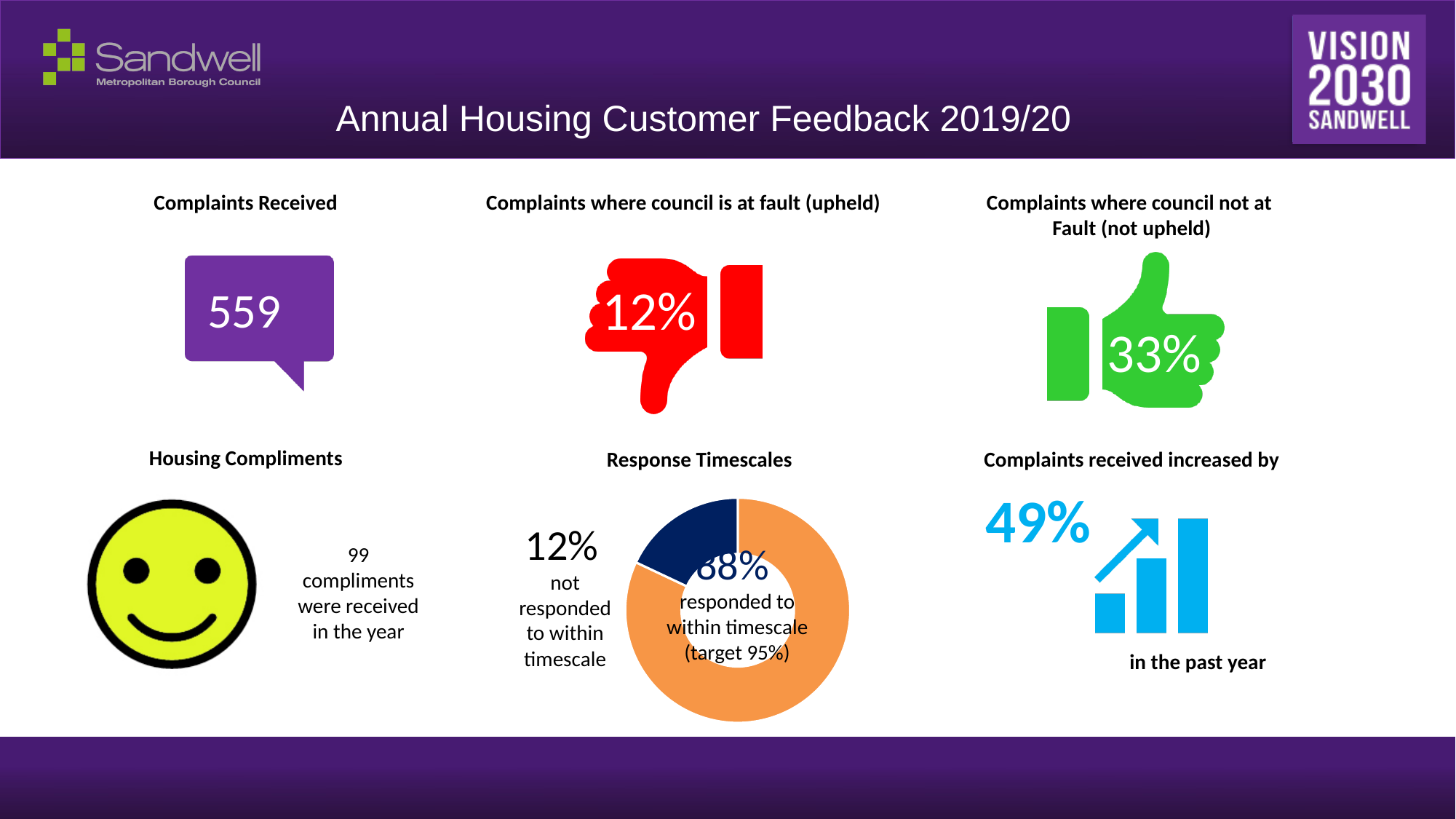
In the Response Timescales chart, which category has the smallest share? not responded to within timescale In the Response Timescales chart, what colour is the segment for complaints not responded to within timescale? dark navy blue In the Response Timescales chart, which segment is larger: responded to within timescale or not responded to within timescale? responded to within timescale In the Response Timescales chart, what percentage of complaints were not responded to within timescale? 12% How many segments does the Response Timescales doughnut chart have? 2 What kind of chart is shown under the heading 'Response Timescales'? doughnut chart In the Response Timescales chart, what percentage of complaints were responded to within timescale? 88% What is the heading above the doughnut chart on the slide? Response Timescales In the Response Timescales chart, what target percentage is stated for responding within timescale? 95% In the Response Timescales chart, what is the difference in percentage points between complaints responded to within timescale and those not responded to within timescale? 76 percentage points In the Response Timescales chart, do the two segments add up to 100%? Yes